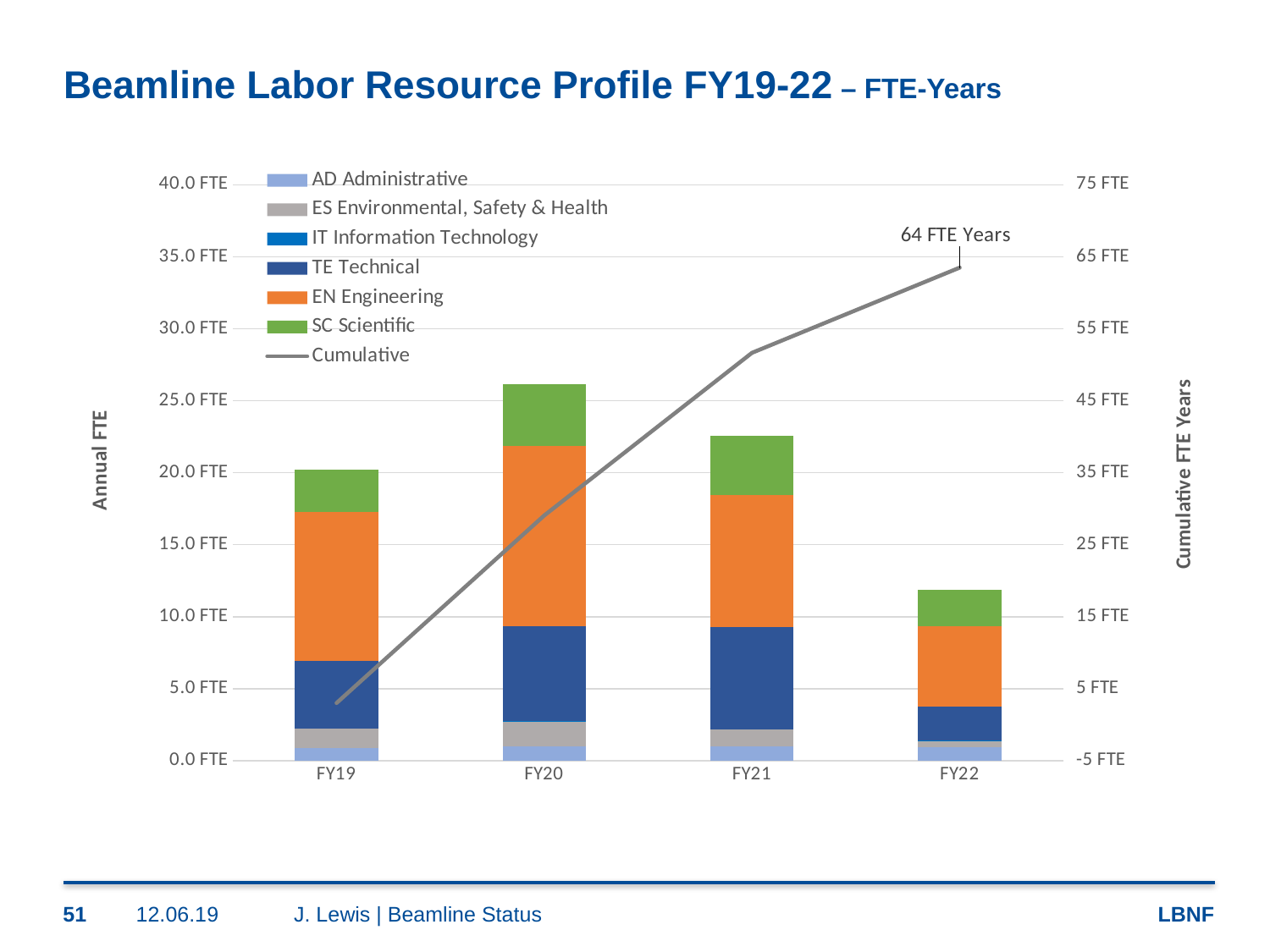
Which fiscal year has the shortest stacked bar? FY22 What is the title of the chart's left vertical axis? Annual FTE How many series does the legend list? 7 Is the total annual FTE for FY20 greater or less than 20.0 FTE? greater What is the cumulative value labelled at FY22? 64 FTE Years How many fiscal years are shown on the x axis? 4 Which has the larger total annual FTE, FY19 or FY22? FY19 What kind of chart is shown on the slide? A stacked bar chart with a line Which legend entry is shown in orange? EN Engineering Does the Cumulative line rise or fall from FY19 to FY22? Rises Which fiscal year has the tallest stacked bar? FY20 Is the total annual FTE for FY22 greater or less than 15.0 FTE? less